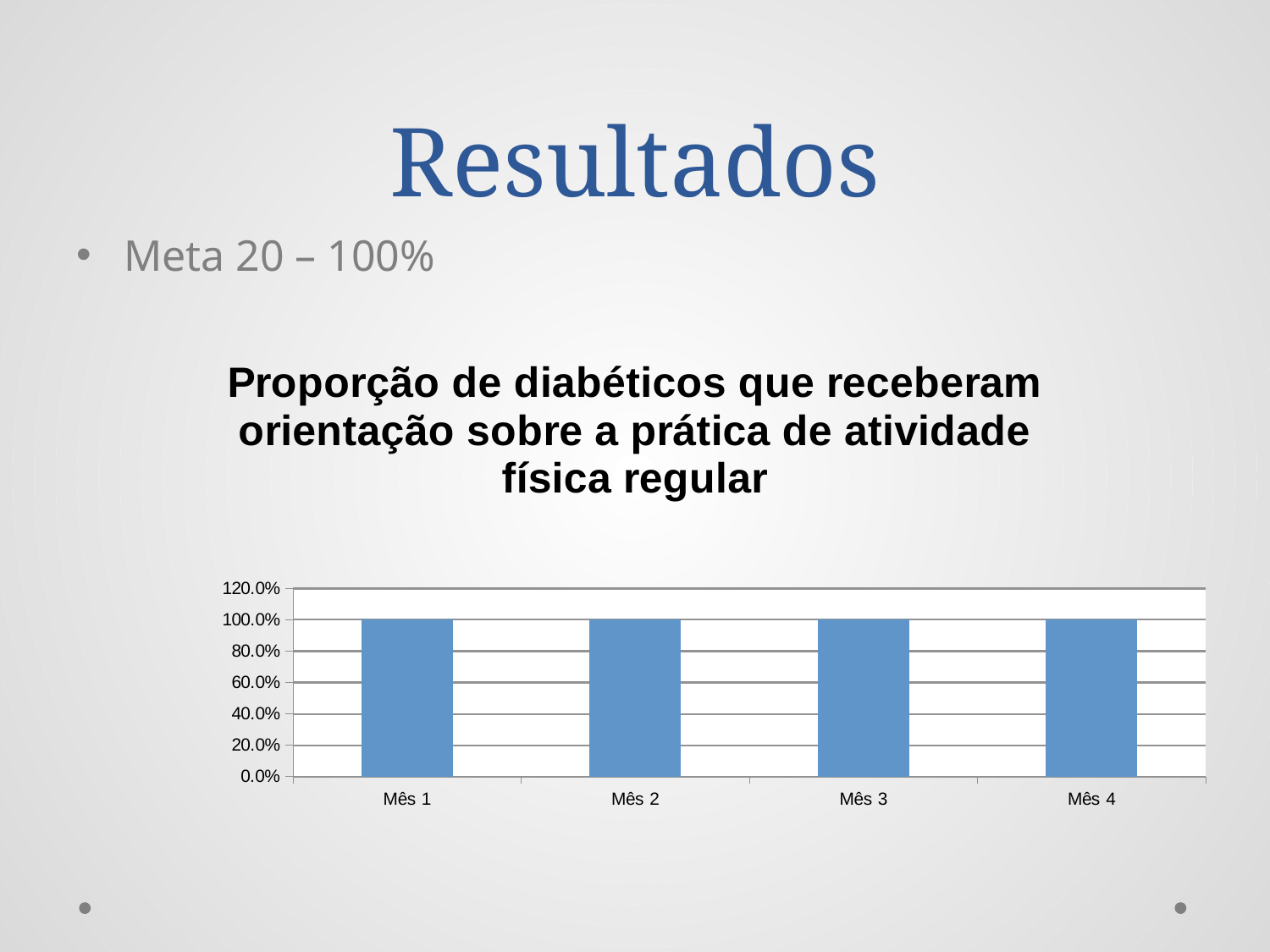
What is the label of the first category on the x axis? Mês 1 What is the value for Mês 1 in the chart? 100.0% What is the title of the chart? Proporção de diabéticos que receberam orientação sobre a prática de atividade física regular What kind of chart is shown on the slide? Bar chart What is the value for Mês 4 in the chart? 100.0% Is the value for Mês 4 greater or less than 120.0%? less What is the difference between the values for Mês 1 and Mês 2? 0.0% Is the value for Mês 2 greater or less than 80.0%? greater Do the values rise, fall, or stay the same from Mês 1 to Mês 4? Stay the same What is the value for Mês 3 in the chart? 100.0% What is the highest value shown on the y axis of the chart? 120.0% How many categories are plotted on the x axis of the chart? 4